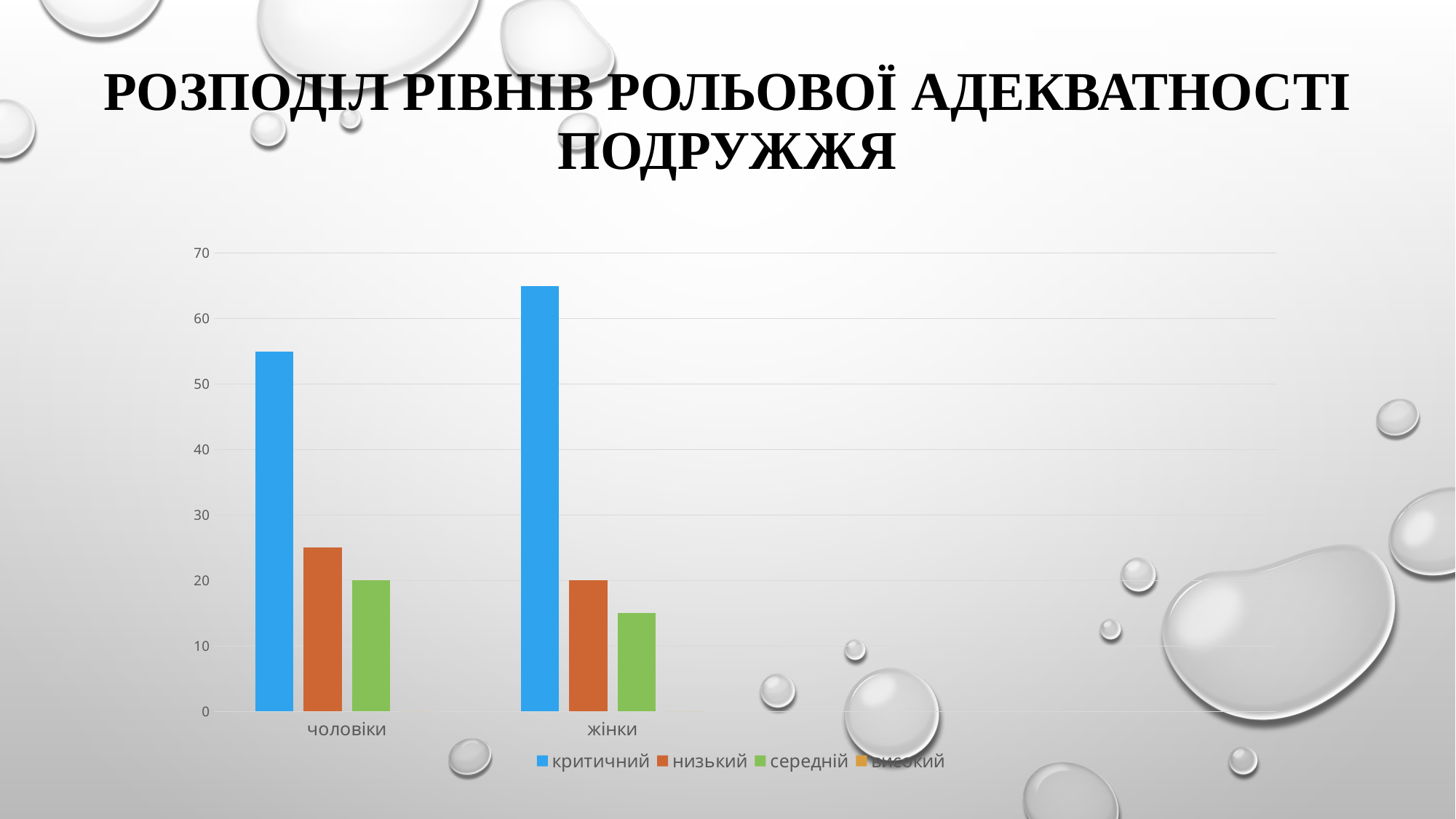
Is the критичний value for чоловіки greater or less than 50? greater Is the низький value for чоловіки greater or less than 30? less What kind of chart is shown on the slide? bar chart What is the title of the chart slide? РОЗПОДІЛ РІВНІВ РОЛЬОВОЇ АДЕКВАТНОСТІ ПОДРУЖЖЯ Which series has the highest bar for жінки? критичний How many series does the legend list? 4 Is the середній value for жінки greater or less than 20? less Which category has the larger середній value, чоловіки or жінки? чоловіки Which category has the larger критичний value, чоловіки or жінки? жінки How many categories are shown on the x axis? 2 Which series has the lowest visible bar for чоловіки? середній